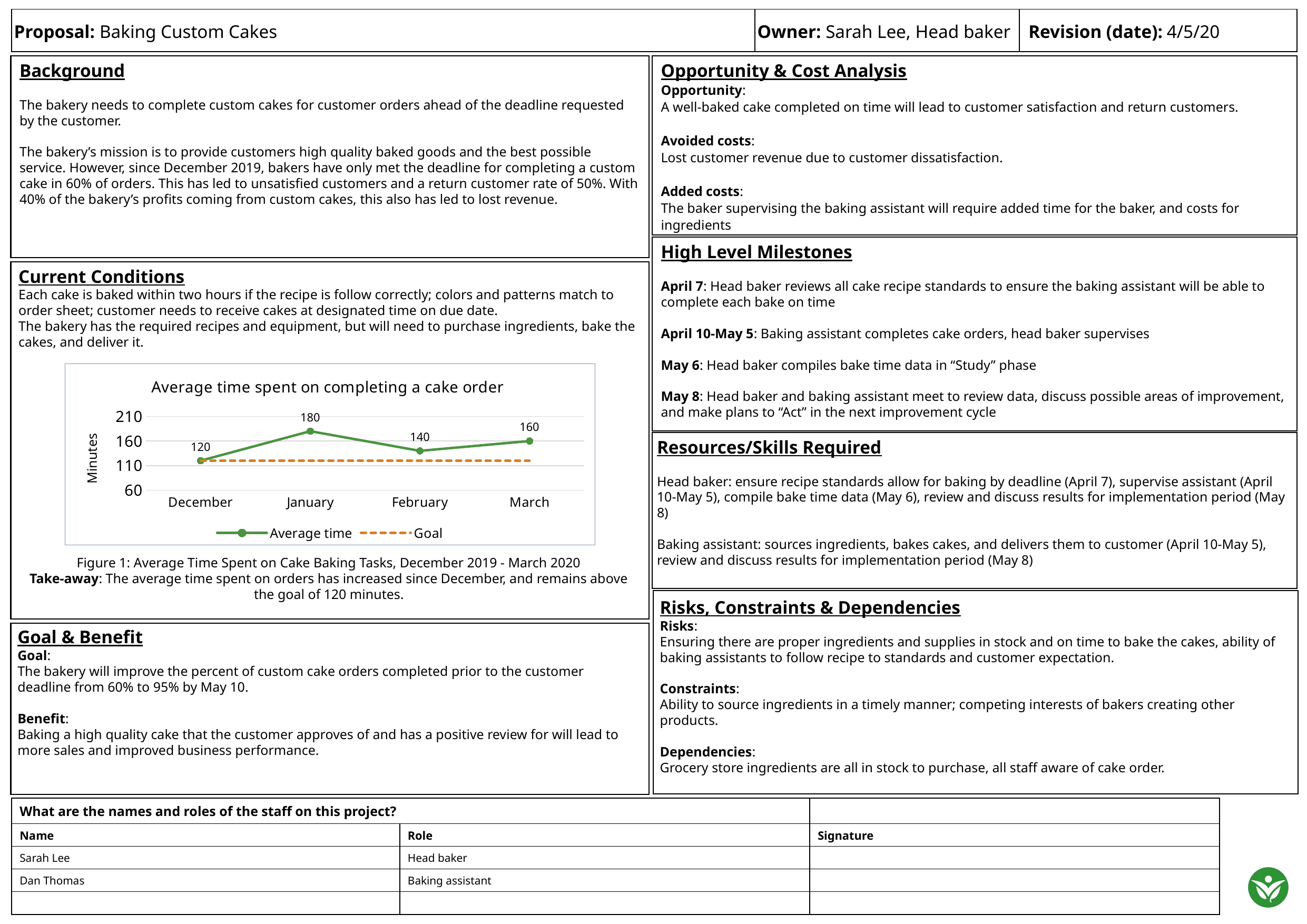
What is the average time for December in the chart? 120 Which is larger, the average time for March or the average time for February? March What kind of chart is shown on the slide? line chart What is the average time for January in the chart? 180 Which month has the highest average time in the chart? January Is the average time for January greater or less than 160? greater What is the average time for March in the chart? 160 How many months are plotted on the x axis of the chart? 4 What is the difference between the average time in January and the average time in February? 40 How many series does the chart legend list? 2 What is the title of the chart? Average time spent on completing a cake order Which month has the lowest average time in the chart? December